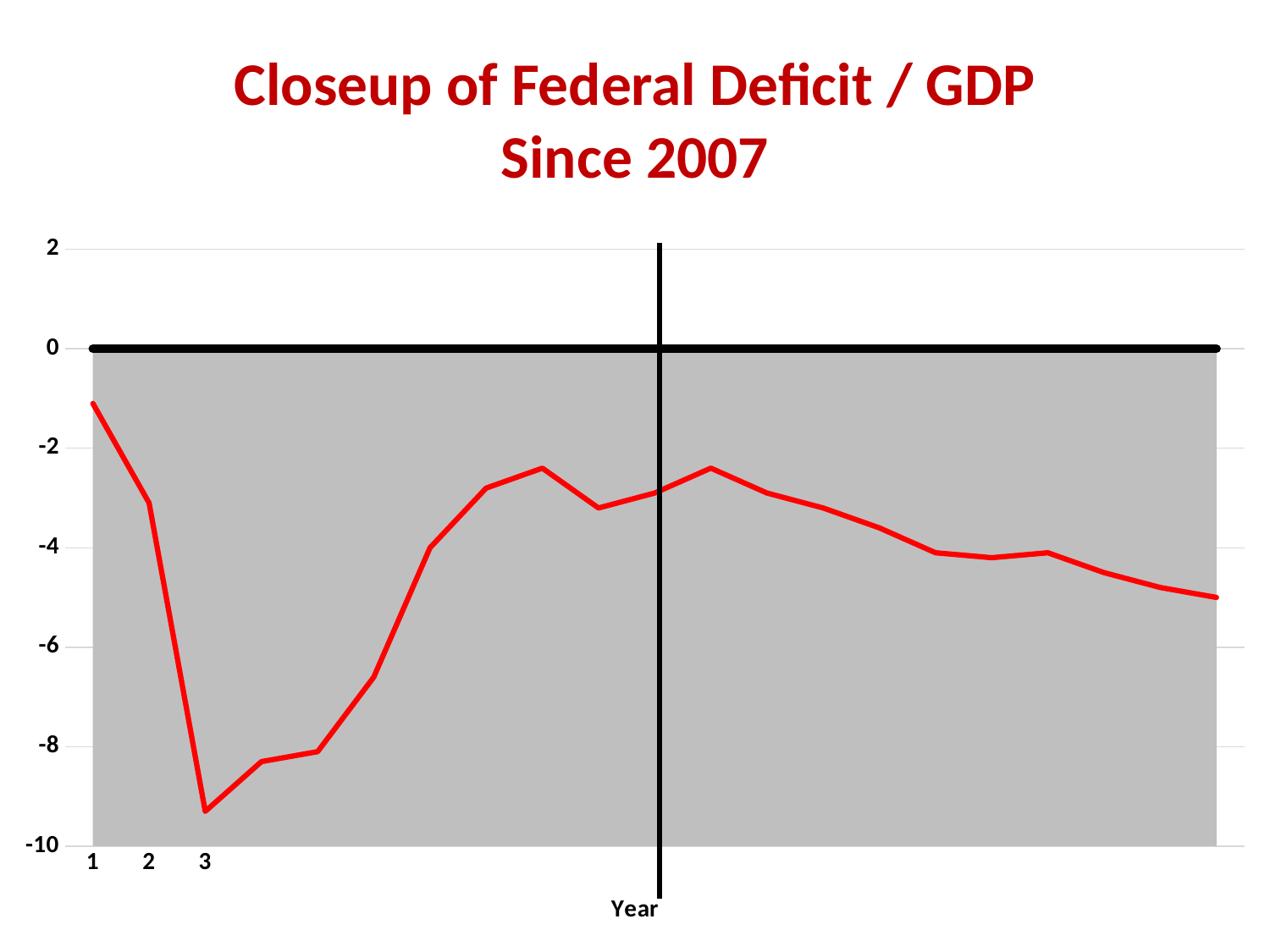
Is the value for year 3 greater or less than -8? less Does the line ever rise above 0 on the chart? no What kind of chart is shown on the slide? line chart Which is larger, the value for year 1 or the value for year 2? year 1 Is the value for year 2 greater or less than -2? less Which labeled year has the lowest value on the line? 3 What is the label of the x axis? Year What is the title of the chart? Closeup of Federal Deficit / GDP Since 2007 Does the line rise or fall from year 1 to year 3? fall Which is larger, the value for year 2 or the value for year 3? year 2